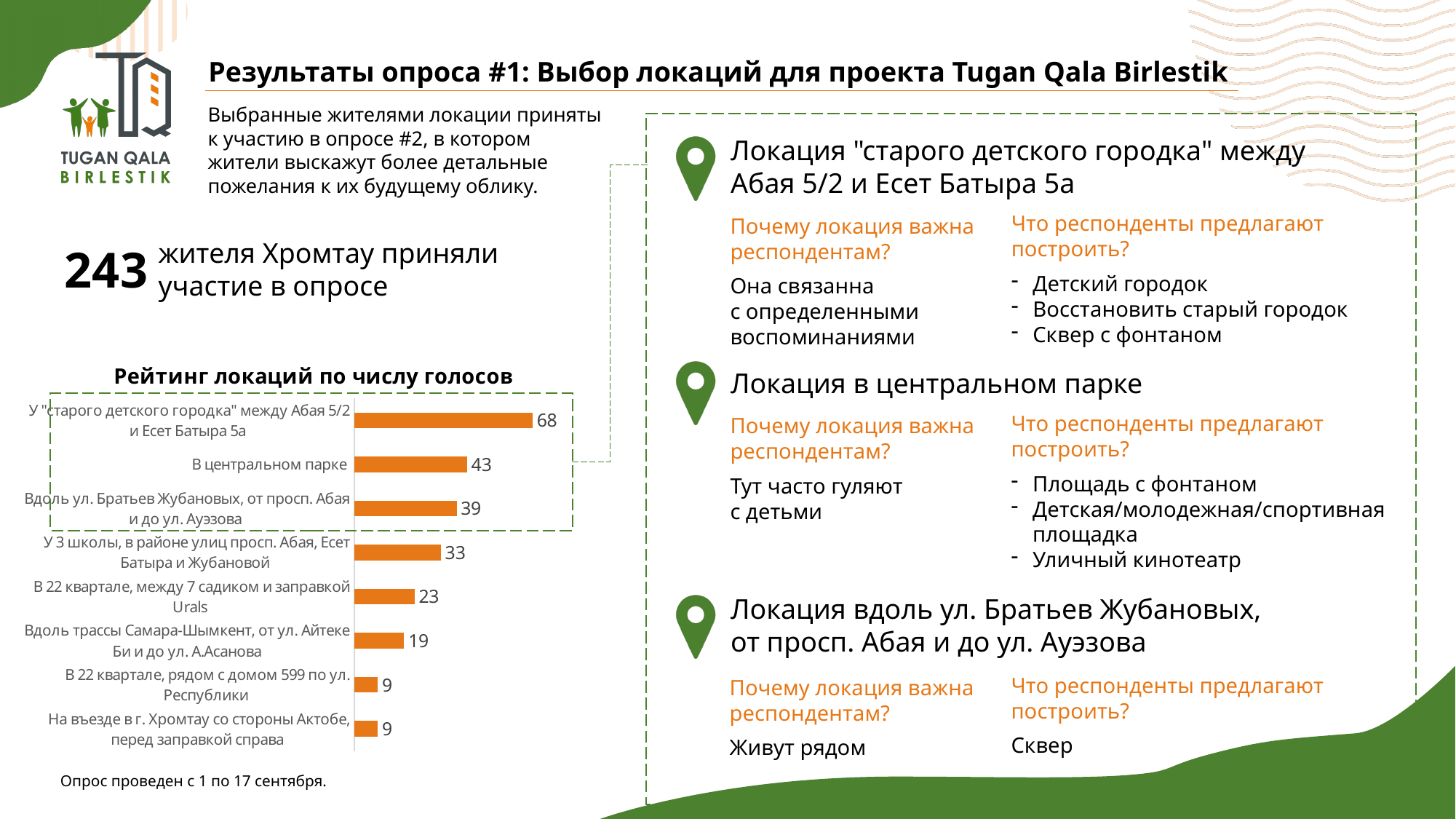
What is the value for "У 3 школы, в районе улиц просп. Абая, Есет Батыра и Жубановой" in the bar chart? 33 What is the difference in votes between "У "старого детского городка" между Абая 5/2 и Есет Батыра 5а" and "В центральном парке"? 25 How many votes did the location "В центральном парке" receive in the chart "Рейтинг локаций по числу голосов"? 43 What is the lowest value shown in the bar chart? 9 Do the values in the chart rise or fall from the top bar to the bottom bar? Fall Which location has the highest number of votes in the chart "Рейтинг локаций по числу голосов"? У "старого детского городка" между Абая 5/2 и Есет Батыра 5а What is the difference between the values for "Вдоль ул. Братьев Жубановых, от просп. Абая и до ул. Ауэзова" and "В 22 квартале, между 7 садиком и заправкой Urals"? 16 Which received more votes: "В центральном парке" or "Вдоль ул. Братьев Жубановых, от просп. Абая и до ул. Ауэзова"? В центральном парке How many locations are listed in the chart "Рейтинг локаций по числу голосов"? 8 What colour are the bars in the chart "Рейтинг локаций по числу голосов"? Orange How many votes are shown for "Вдоль трассы Самара-Шымкент, от ул. Айтеке Би и до ул. А.Асанова"? 19 What type of chart is "Рейтинг локаций по числу голосов"? Bar chart